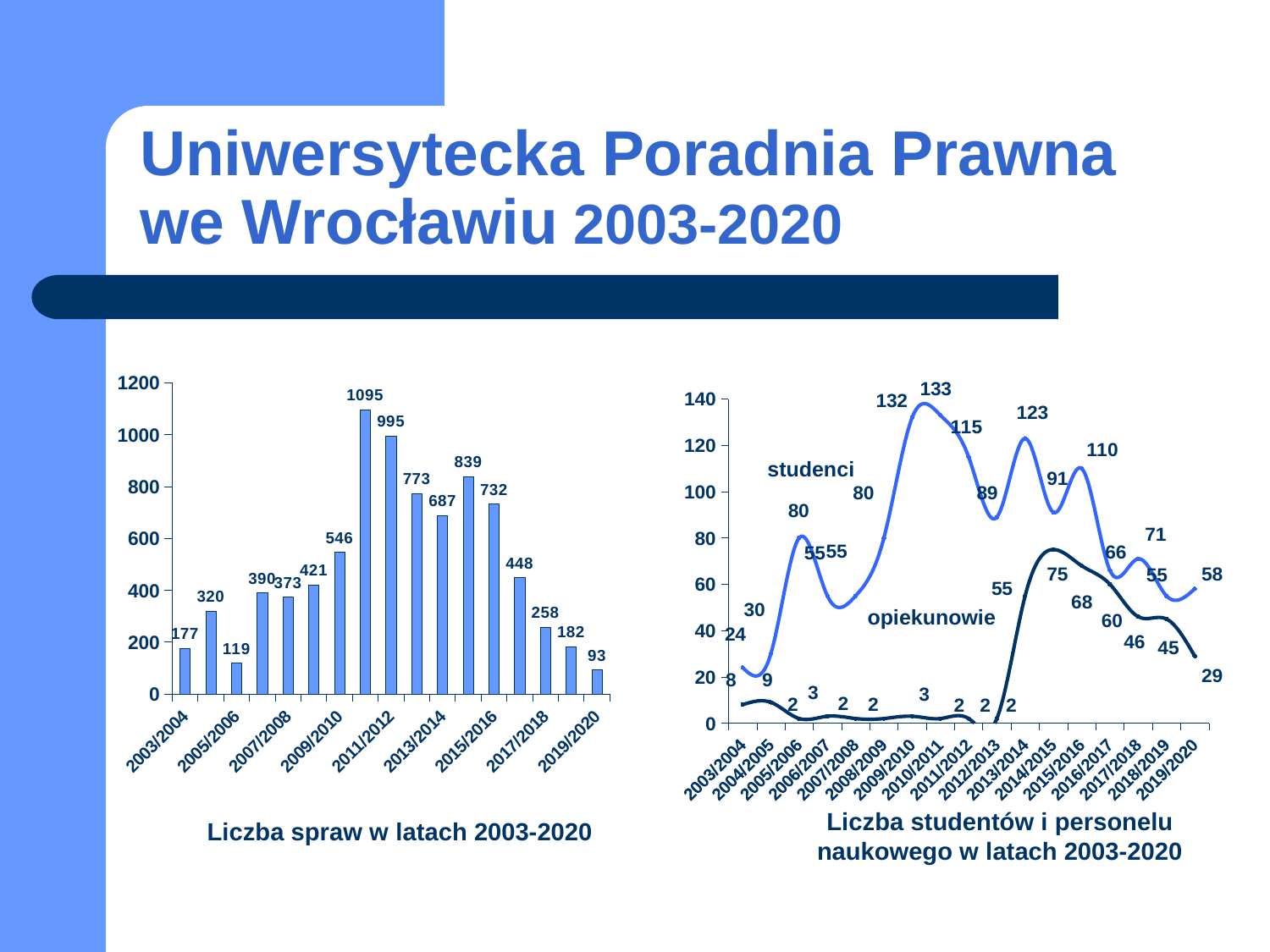
In the chart titled "Liczba spraw w latach 2003-2020", which year has the lowest value? 2019/2020 In the chart titled "Liczba studentów i personelu naukowego w latach 2003-2020", how many series are plotted? 2 In the chart titled "Liczba studentów i personelu naukowego w latach 2003-2020", which series has the higher value for 2003/2004, studenci or opiekunowie? studenci What kind of chart is the one titled "Liczba spraw w latach 2003-2020"? bar chart In the chart titled "Liczba studentów i personelu naukowego w latach 2003-2020", what is the value of the opiekunowie series for 2019/2020? 29 In the chart titled "Liczba spraw w latach 2003-2020", do the values rise or fall from 2015/2016 to 2019/2020? fall In the chart titled "Liczba spraw w latach 2003-2020", what is the difference between the two tallest bars, 1095 and 995? 100 In the chart titled "Liczba spraw w latach 2003-2020", what is the value for 2019/2020? 93 In the chart titled "Liczba spraw w latach 2003-2020", how many bars are plotted? 17 In the chart titled "Liczba studentów i personelu naukowego w latach 2003-2020", what is the highest value of the studenci series? 133 In the chart titled "Liczba spraw w latach 2003-2020", what is the highest value shown? 1095 In the chart titled "Liczba spraw w latach 2003-2020", what is the value for 2003/2004? 177